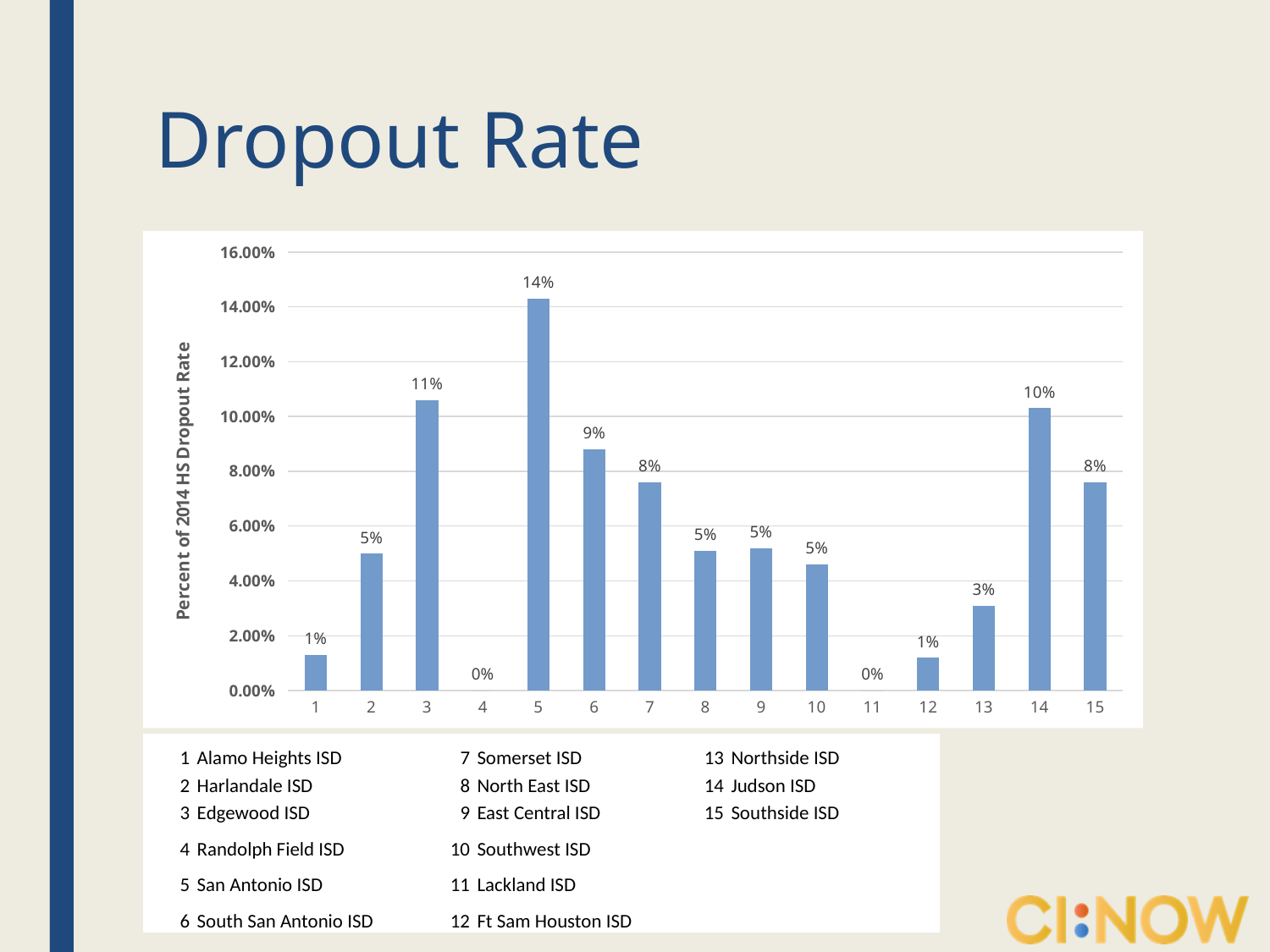
What is the dropout rate shown for category 13 (Northside ISD)? 3% How many categories (school districts) are plotted on the chart? 15 What is the difference between the labelled dropout rates of category 5 and category 14? 4 percentage points Is the value for category 5 greater or less than 12.00%? greater What is the dropout rate shown for category 14 (Judson ISD)? 10% What kind of chart is shown on the slide? Bar chart Which has a higher dropout rate, category 6 (South San Antonio ISD) or category 7 (Somerset ISD)? 6 (South San Antonio ISD) What is the dropout rate shown for category 11 (Lackland ISD)? 0% What is the dropout rate shown for category 5 (San Antonio ISD)? 14% What is the dropout rate shown for category 3 (Edgewood ISD)? 11% Which category has the highest dropout rate? 5 (San Antonio ISD) Is the value for category 13 greater or less than 4.00%? less